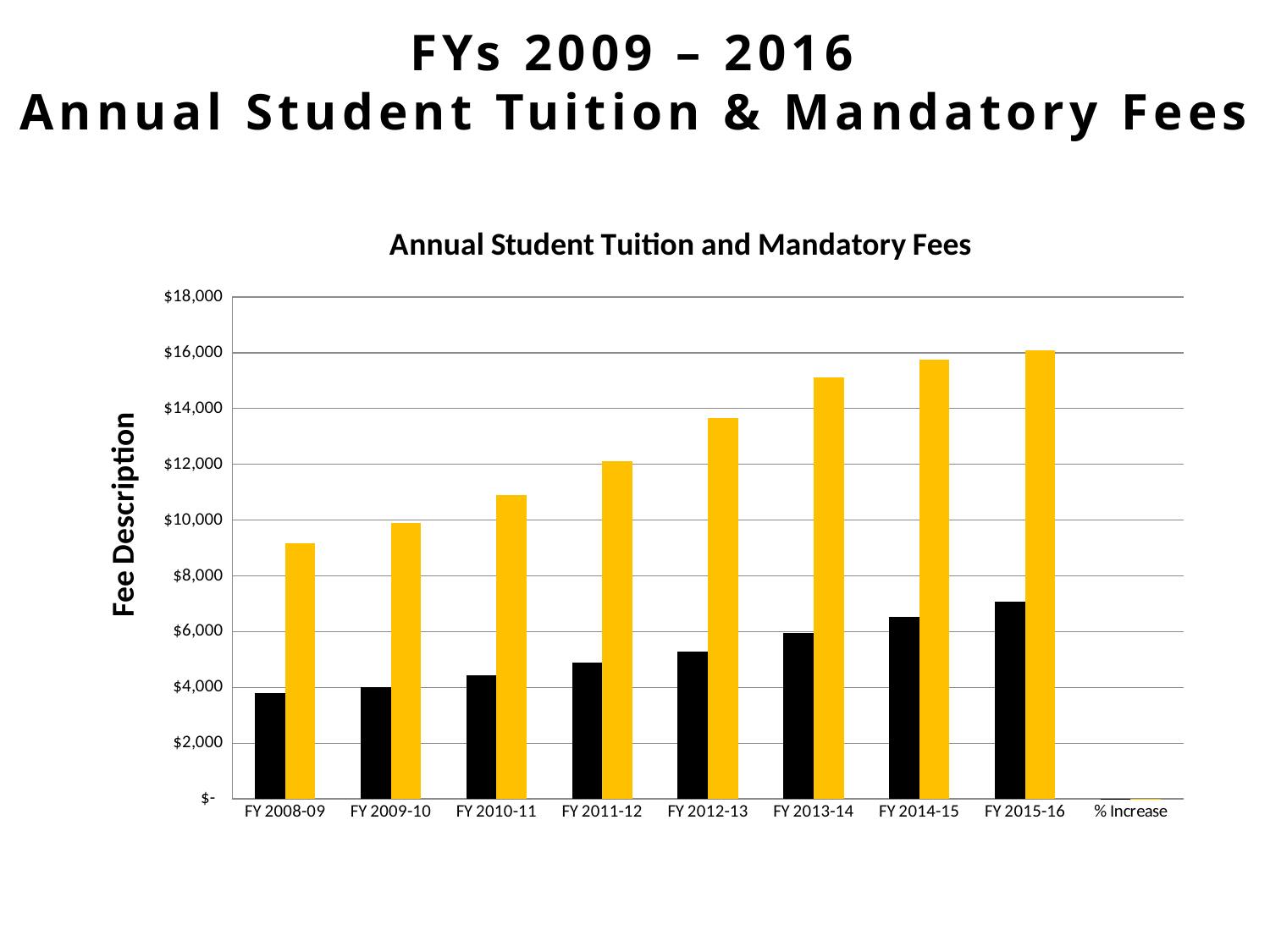
What kind of chart is shown on the slide? bar chart What is the title of the chart? Annual Student Tuition and Mandatory Fees Do the yellow bars rise or fall from FY 2008-09 to FY 2015-16? rise Among the fiscal years, which has the shortest yellow bar? FY 2008-09 Is the yellow bar for FY 2008-09 greater or less than $10,000? less In FY 2013-14, which bar is taller, the yellow bar or the black bar? the yellow bar What is the label on the vertical axis of the chart? Fee Description Is the black bar for FY 2015-16 greater or less than $6,000? greater How many categories are shown along the x axis of the chart? 9 Among the fiscal years, which has the tallest black bar? FY 2015-16 Among the fiscal years, which has the tallest yellow bar? FY 2015-16 Do the black bars rise or fall from FY 2008-09 to FY 2015-16? rise